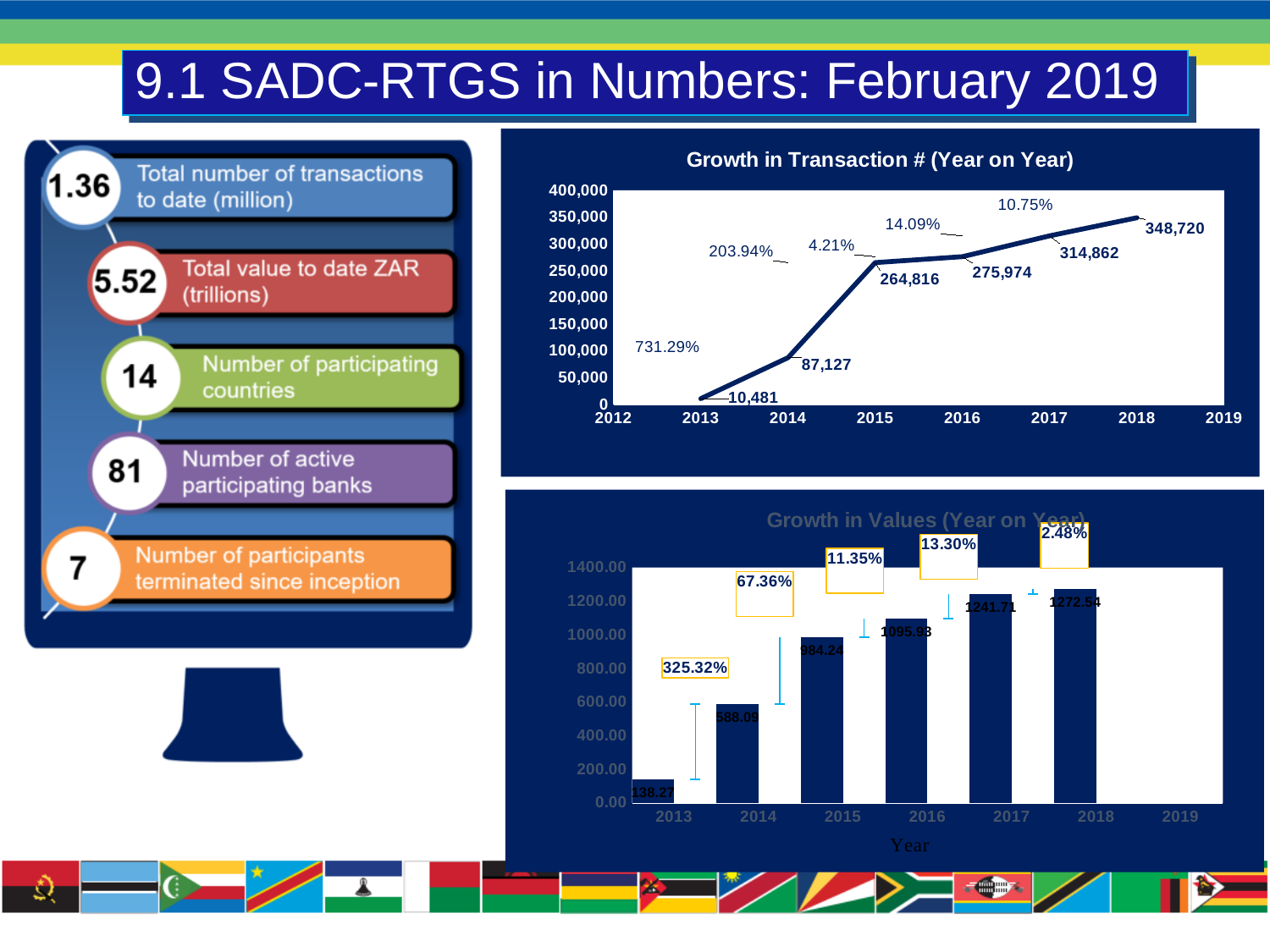
In the 'Growth in Transaction # (Year on Year)' chart, what kind of chart is shown? Line chart In the 'Growth in Transaction # (Year on Year)' chart, which year has the highest value? 2018 In the 'Growth in Values (Year on Year)' chart, which year has the lowest value? 2013 In the 'Growth in Transaction # (Year on Year)' chart, what is the value for 2013? 10,481 In the 'Growth in Values (Year on Year)' chart, what kind of chart is shown? Bar chart In the 'Growth in Transaction # (Year on Year)' chart, do the values rise or fall from 2013 to 2018? Rise In the 'Growth in Transaction # (Year on Year)' chart, what is the value for 2018? 348,720 In the 'Growth in Values (Year on Year)' chart, is the value for 2015 greater or less than 1000.00? less In the 'Growth in Values (Year on Year)' chart, what is the value for 2016? 1095.93 In the 'Growth in Transaction # (Year on Year)' chart, what is the difference between the 2015 and 2014 values? 177,689 In the 'Growth in Values (Year on Year)' chart, which is larger, the value for 2014 or the value for 2015? 2015 In the 'Growth in Values (Year on Year)' chart, how many bars are plotted? 6